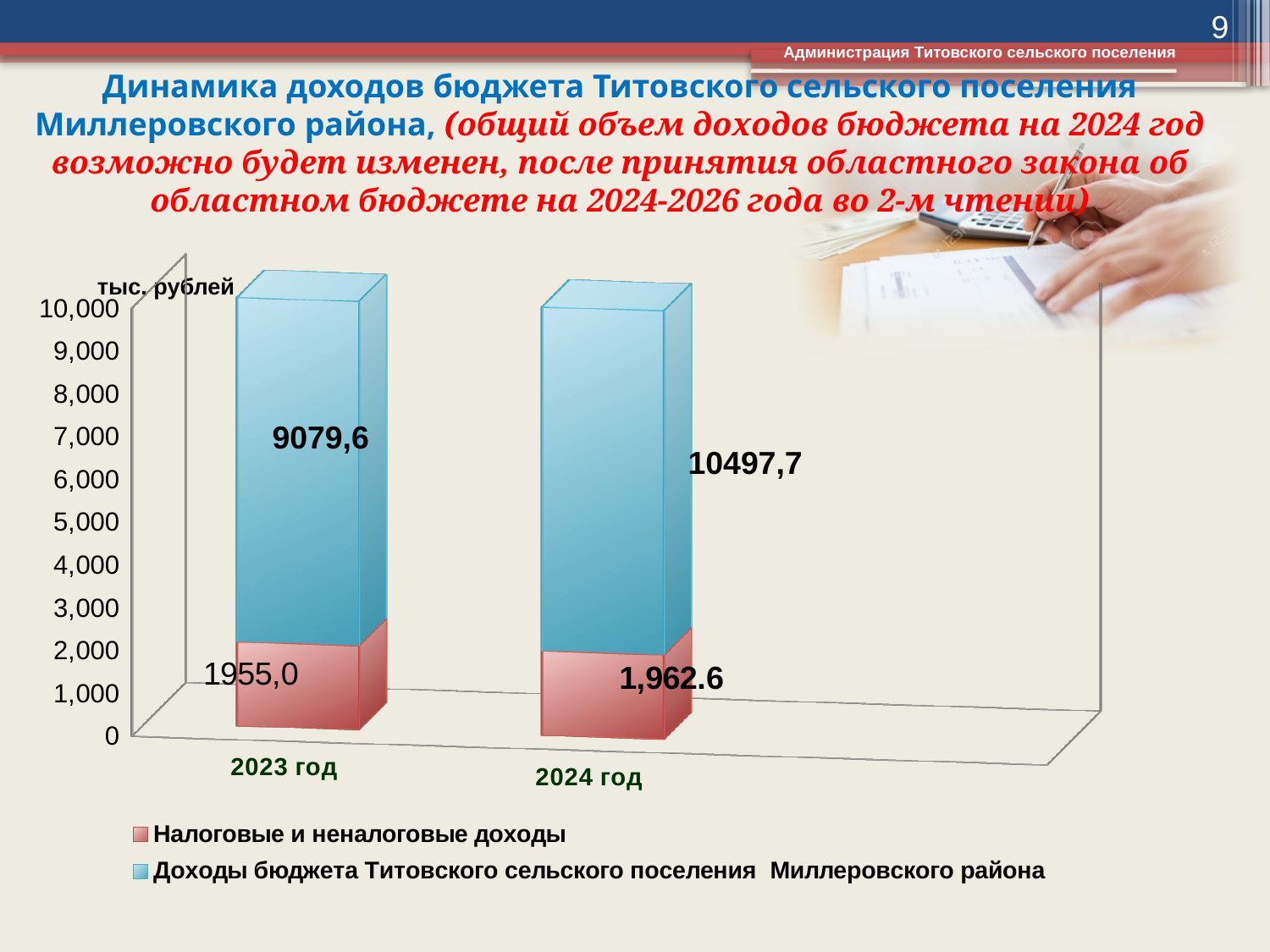
What unit is indicated at the top of the vertical axis? тыс. рублей Which series is shown in red/pink in the legend? Налоговые и неналоговые доходы What is the difference between the 'Доходы бюджета Титовского сельского поселения Миллеровского района' values for 2024 год and 2023 год? 1418,1 What is the value of 'Налоговые и неналоговые доходы' for 2024 год? 1,962.6 What is the value of 'Налоговые и неналоговые доходы' for 2023 год? 1955,0 What kind of chart is shown on the slide? Bar chart How many series does the legend list? 2 Which year has the higher value for 'Доходы бюджета Титовского сельского поселения Миллеровского района'? 2024 год How many year categories are shown on the x axis? 2 Does the 'Доходы бюджета Титовского сельского поселения Миллеровского района' series rise or fall from 2023 год to 2024 год? Rise What is the value of the 'Доходы бюджета Титовского сельского поселения Миллеровского района' series for 2024 год? 10497,7 What is the value of the 'Доходы бюджета Титовского сельского поселения Миллеровского района' series for 2023 год? 9079,6